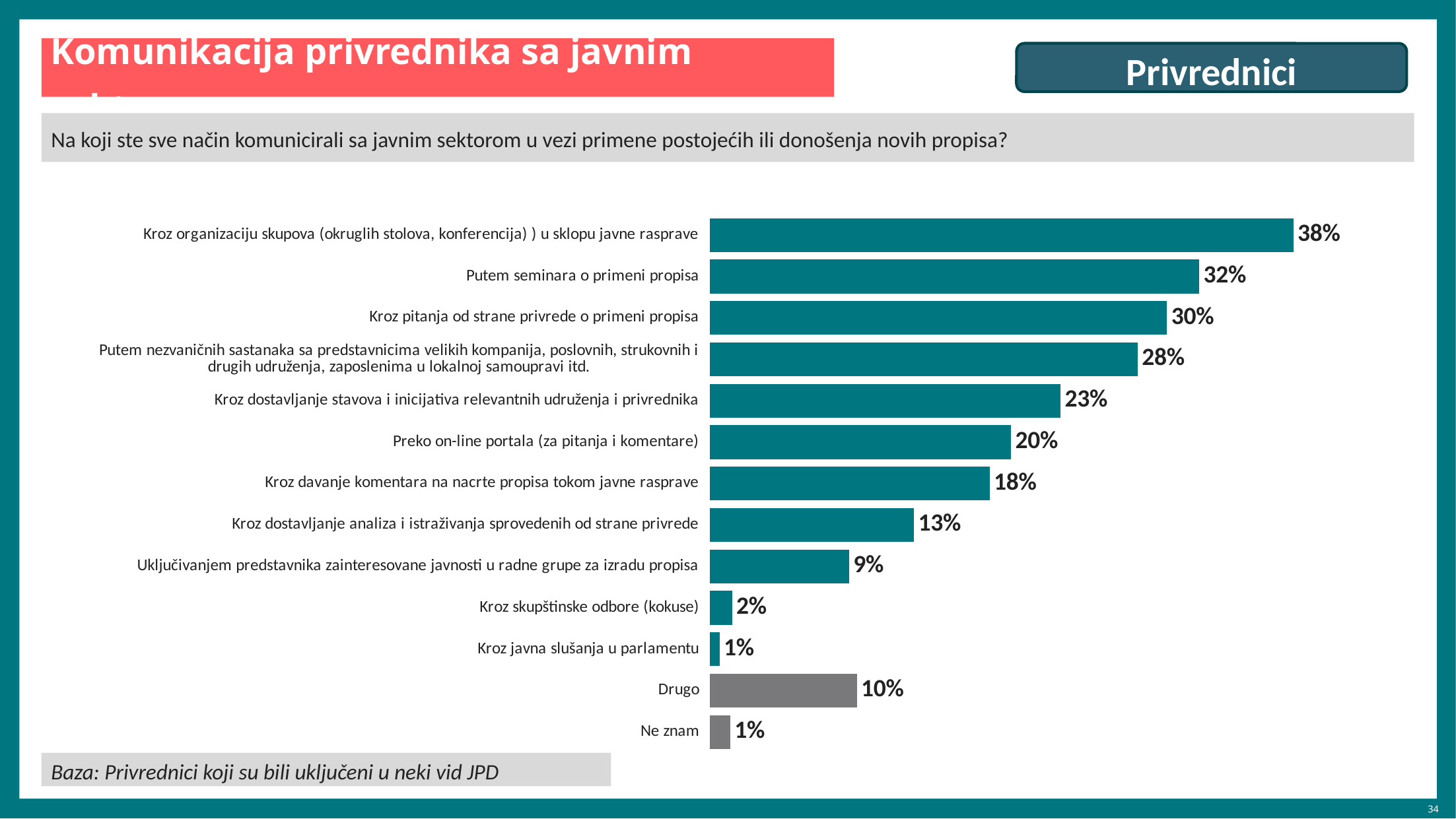
What is the value for "Kroz dostavljanje stavova i inicijativa relevantnih udruženja i privrednika"? 23% What is the value for "Putem seminara o primeni propisa"? 32% Which categories are shown with grey bars instead of teal bars? Drugo and Ne znam What is the difference between the highest value and the value for "Putem nezvaničnih sastanaka sa predstavnicima velikih kompanija, poslovnih, strukovnih i drugih udruženja, zaposlenima u lokalnoj samoupravi itd."? 10% What is the value for "Preko on-line portala (za pitanja i komentare)"? 20% Which category has the highest value? Kroz organizaciju skupova (okruglih stolova, konferencija) ) u sklopu javne rasprave What is the difference between the values for "Kroz pitanja od strane privrede o primeni propisa" and "Kroz davanje komentara na nacrte propisa tokom javne rasprave"? 12% What is the value for "Kroz skupštinske odbore (kokuse)"? 2% Which is larger: the value for "Kroz dostavljanje analiza i istraživanja sprovedenih od strane privrede" or the value for "Drugo"? Kroz dostavljanje analiza i istraživanja sprovedenih od strane privrede What is the value for "Drugo"? 10% What kind of chart is shown on the slide? Bar chart How many categories are shown in the chart? 13